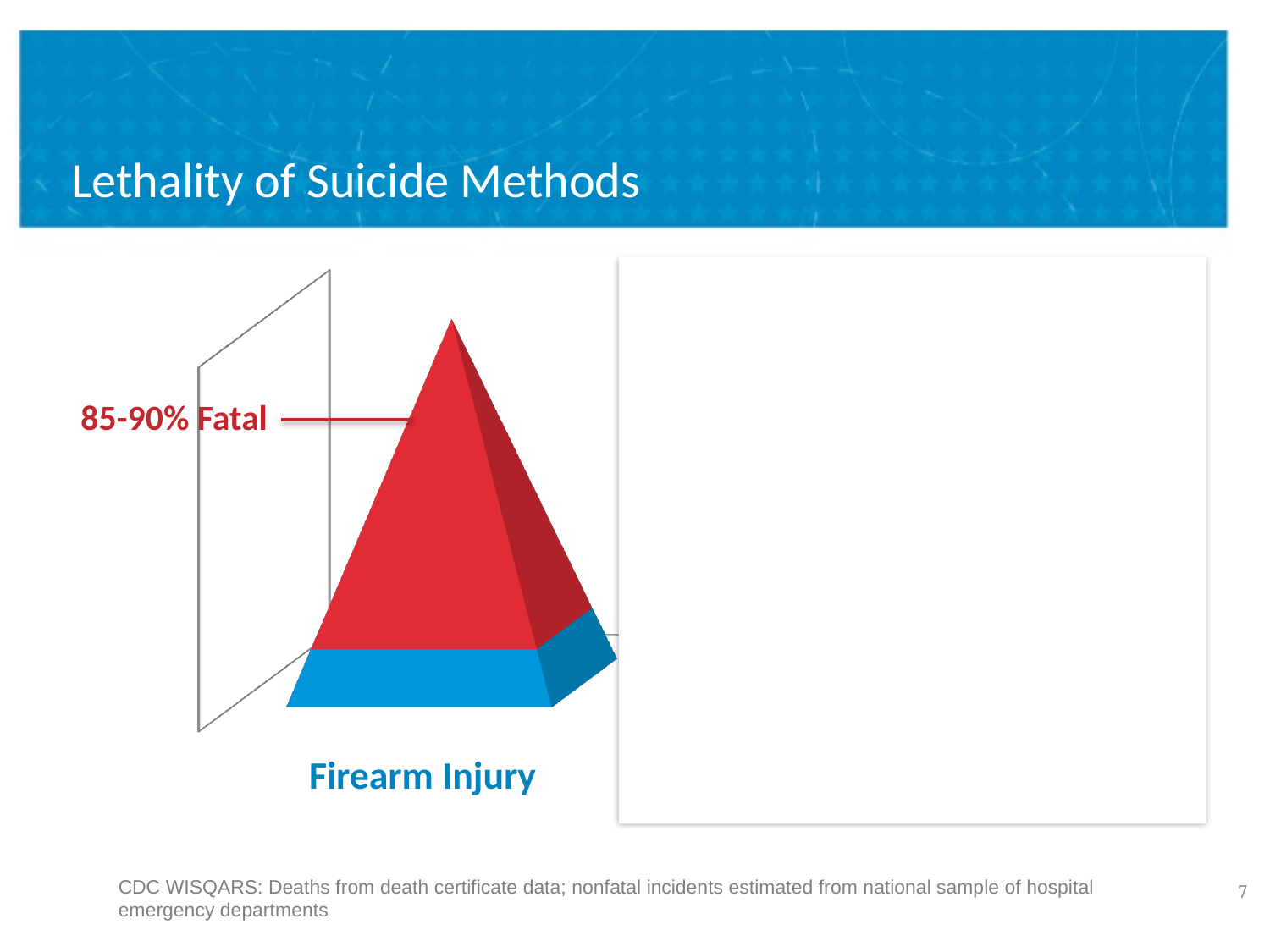
What colour is the bottom segment of the pyramid? Blue What kind of chart is shown on the slide? A 3D stacked bar chart drawn as a pyramid Is the fatal share of firearm injuries greater or less than 50%? greater What label is attached to the red segment of the pyramid? 85-90% Fatal What is the title of the slide containing the pyramid chart? Lethality of Suicide Methods What percentage of firearm injuries is shown as fatal on the pyramid? 85-90% What category does the pyramid chart represent? Firearm Injury Which segment of the pyramid is larger, the red one or the blue one? The red one How many segments does the pyramid have? 2